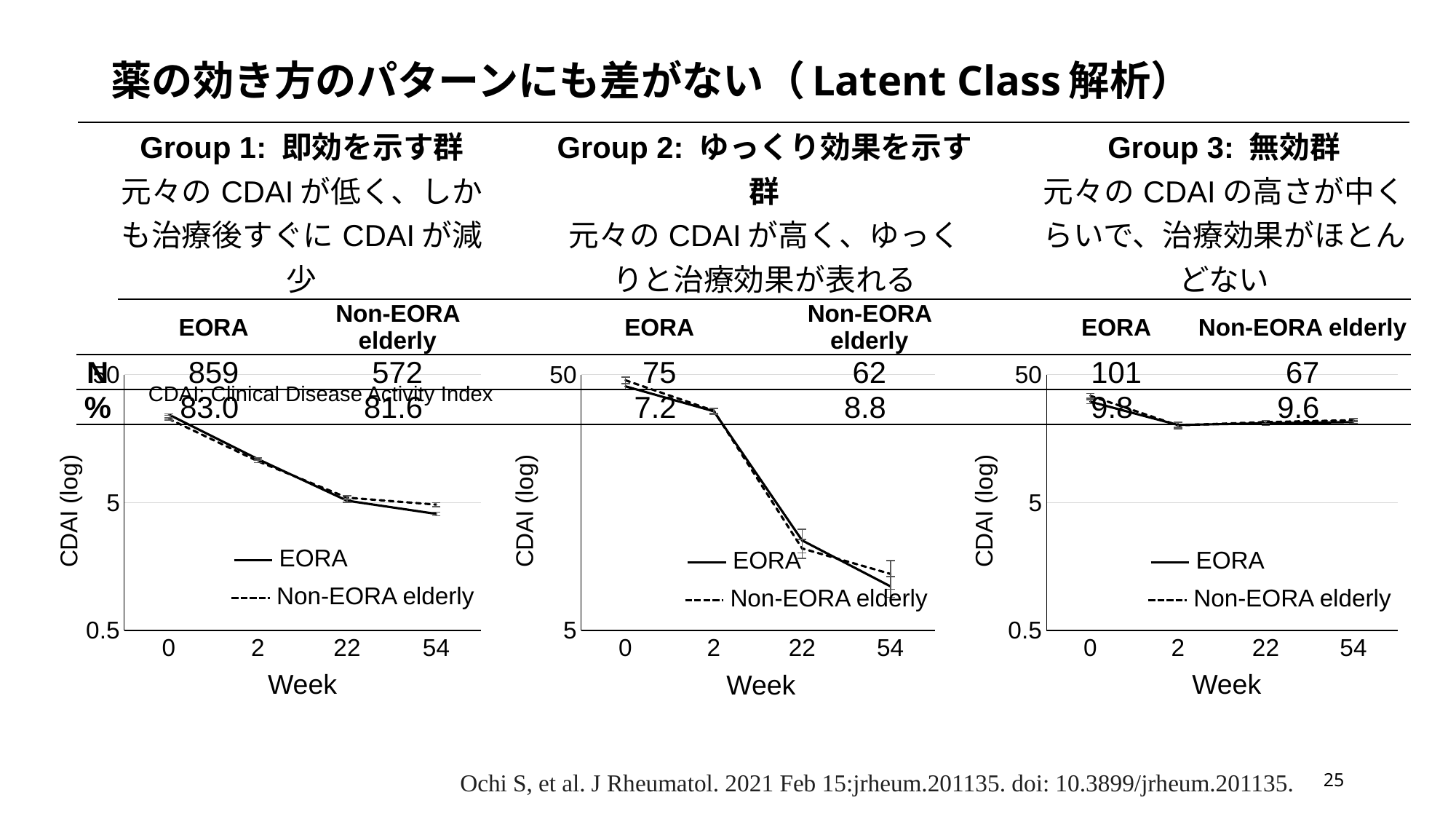
In the Group 2 chart, is the EORA value at week 0 greater or less than 5? greater In the Group 3 chart, is the EORA value at week 54 greater or less than 5? greater What kind of chart is the Group 1 chart on the left? line chart In the Group 1 chart, is the EORA value at week 0 greater or less than 5? greater What is the label of the x axis on the Group 3 chart? Week How many week time points are plotted along the x axis of the Group 3 chart? 4 In the Group 1 chart, does the EORA line rise or fall from week 0 to week 54? fall How many series does the legend of the Group 2 chart list? 2 In the Group 2 chart, does the Non-EORA elderly line rise or fall from week 0 to week 54? fall In the Group 1 chart, which week has the highest EORA value? 0 Which series is drawn with a dashed line in the Group 1 chart? Non-EORA elderly In the Group 2 chart, which week has the lowest EORA value? 54